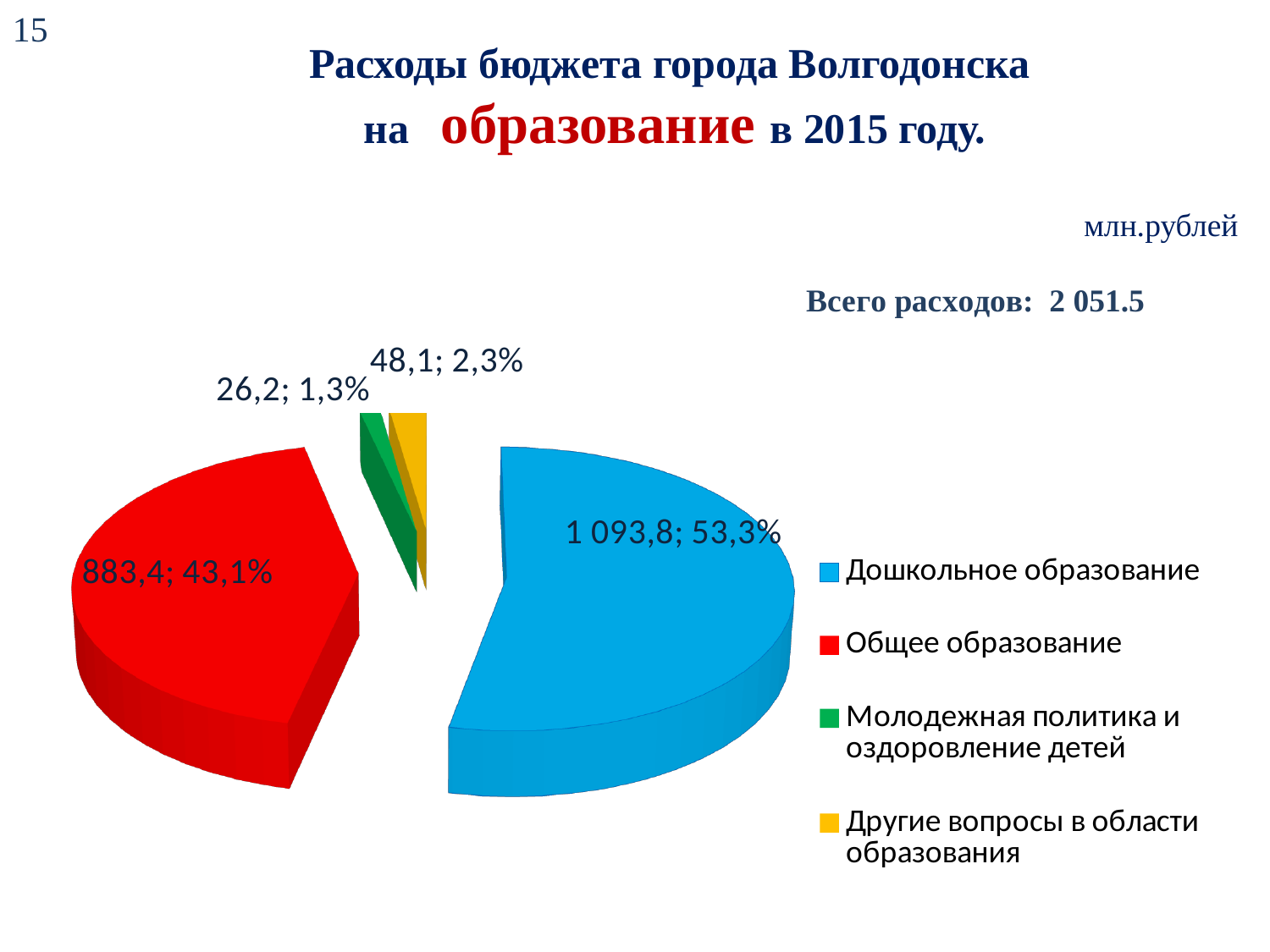
What is the value for Молодежная политика и оздоровление детей? 26,2 What share of the pie does Другие вопросы в области образования represent? 2,3% How many slices does the pie chart have? 4 What is the value for Общее образование? 883,4 Which category has the smallest slice? Молодежная политика и оздоровление детей What total expenditure (Всего расходов) is stated on the slide? 2 051.5 What share of the pie does Общее образование represent? 43,1% What is the value for Другие вопросы в области образования? 48,1 What is the value for Дошкольное образование? 1 093,8 Which is larger, the value for Другие вопросы в области образования or the value for Молодежная политика и оздоровление детей? Другие вопросы в области образования What kind of chart is shown on the slide? Pie chart Which category has the largest slice? Дошкольное образование